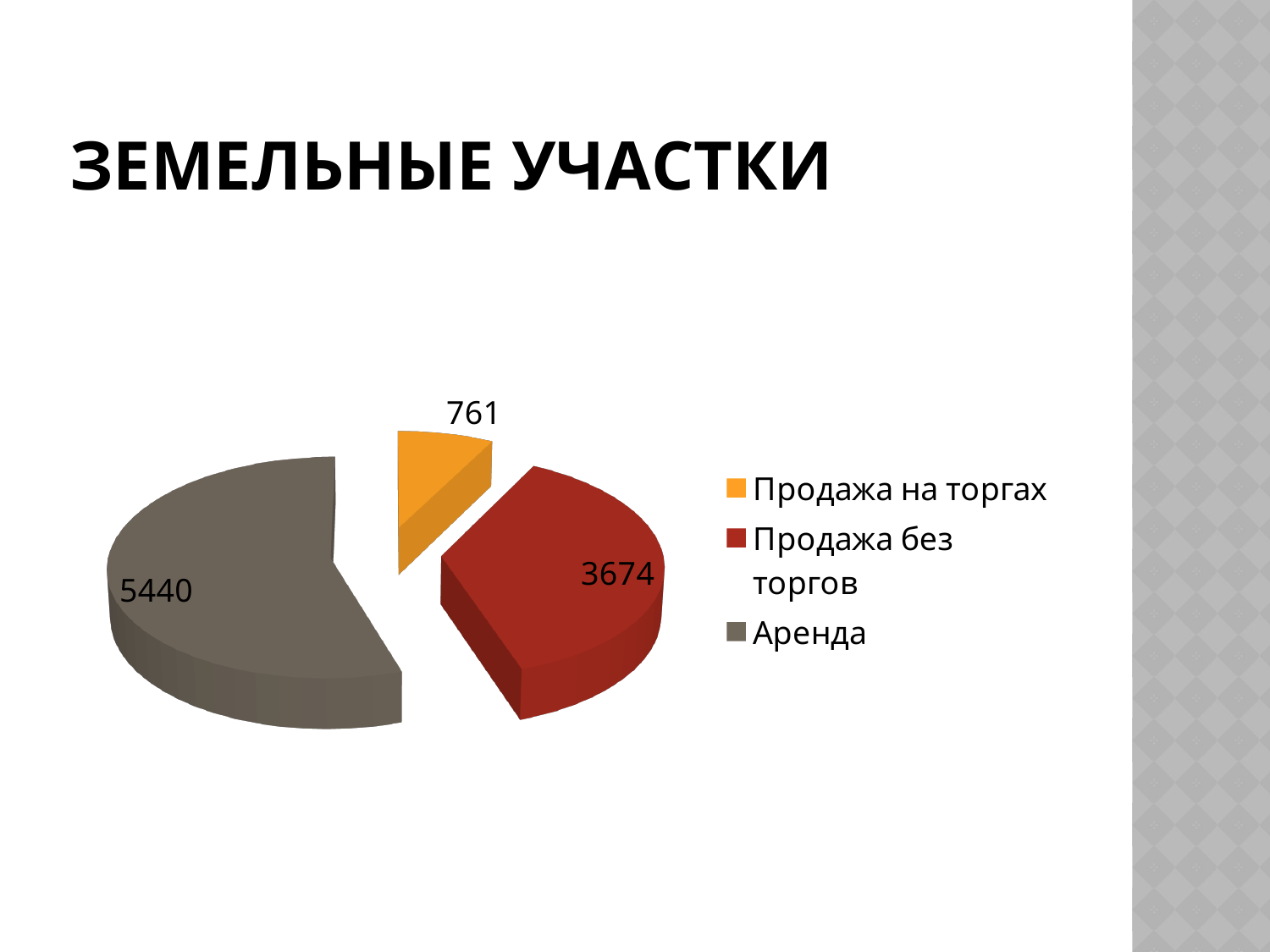
What is the value for Продажа на торгах? 761 What colour is the slice for Аренда? Grey Which category has the largest slice of the pie? Аренда Which category has the smallest slice of the pie? Продажа на торгах What is the value for Аренда? 5440 What is the difference between the values for Продажа без торгов and Продажа на торгах? 2913 What is the value for Продажа без торгов? 3674 What is the total of all slices in the pie chart? 9875 Which is larger, the value for Продажа без торгов or the value for Продажа на торгах? Продажа без торгов How many slices does the pie chart have? 3 What type of chart is shown on the slide? Pie chart What is the difference between the values for Аренда and Продажа без торгов? 1766